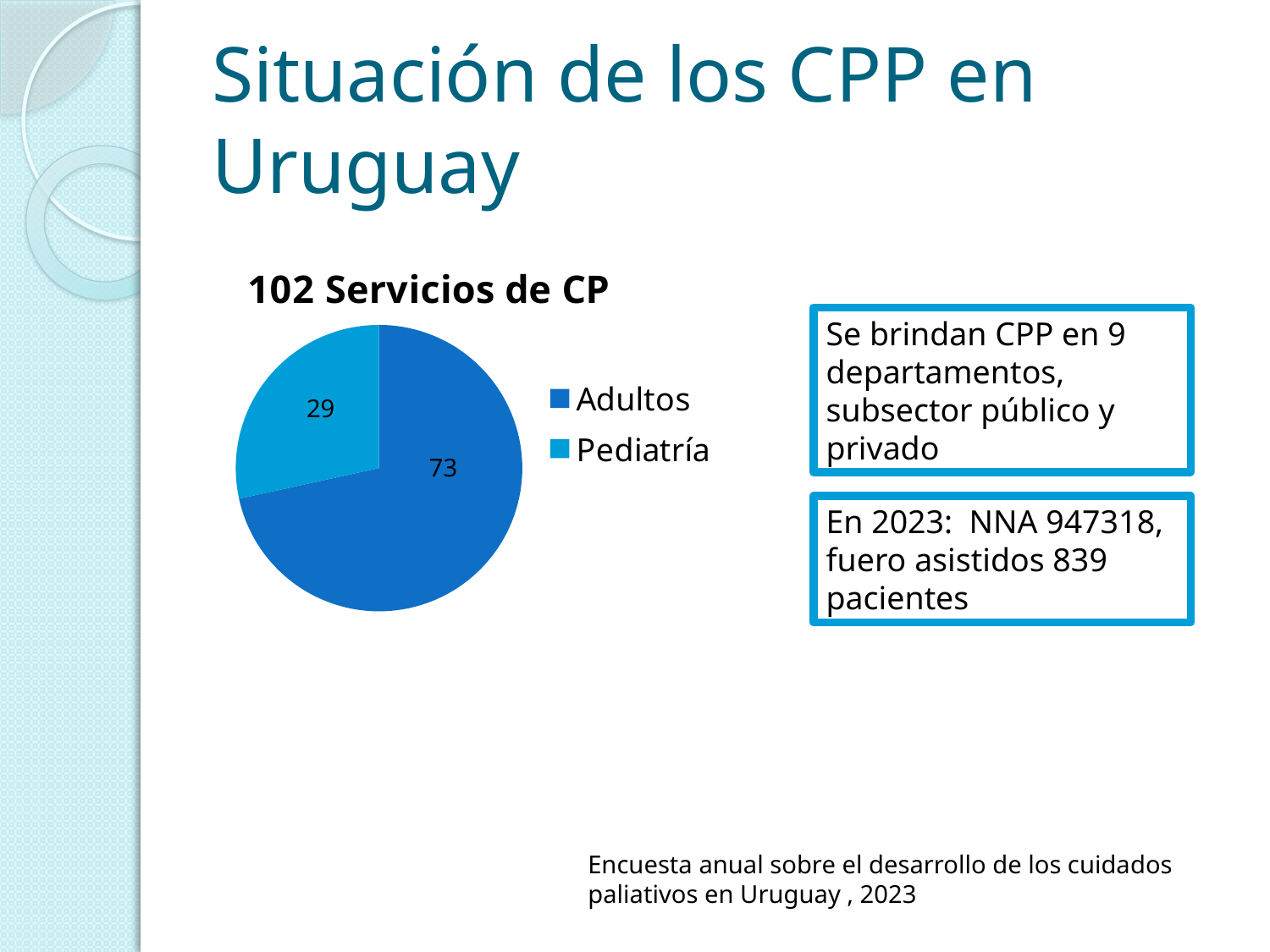
Which legend entry is shown in the lighter blue colour? Pediatría What is the title of the chart? 102 Servicios de CP How many categories does the pie chart show? 2 Which is larger, Adultos or Pediatría? Adultos Which category has the largest slice in the pie chart? Adultos What is the value for Adultos in the pie chart? 73 What kind of chart is shown on the slide? Pie chart Which category has the smallest slice in the pie chart? Pediatría What is the value for Pediatría in the pie chart? 29 How many entries does the legend list? 2 What is the total of the two slices in the pie chart? 102 What is the difference between the Adultos and Pediatría values? 44